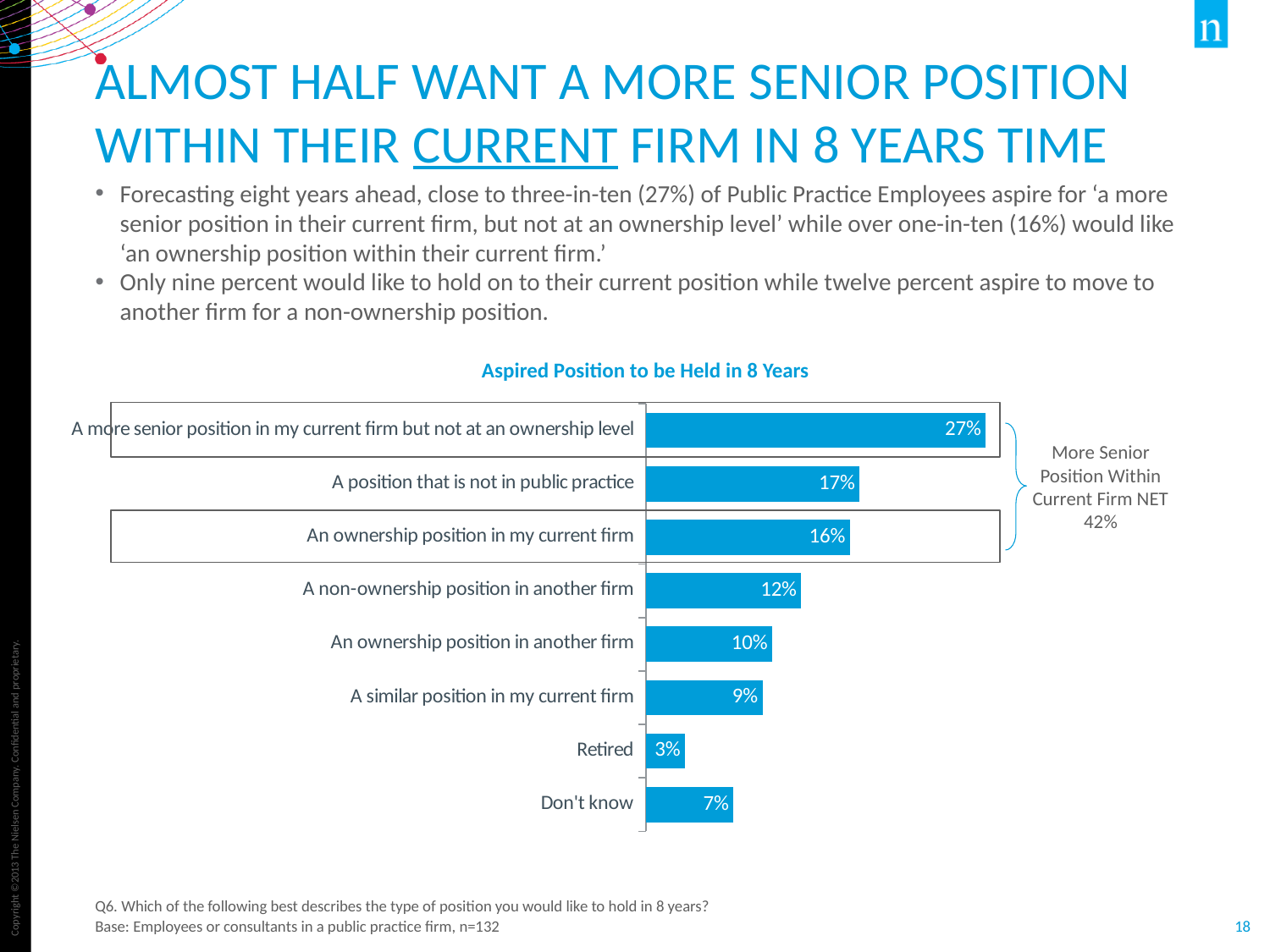
What is the title of the chart? Aspired Position to be Held in 8 Years Which category has the lowest value? Retired What is the difference between 'A more senior position in my current firm but not at an ownership level' and 'An ownership position in my current firm'? 11% What is the value for 'Retired'? 3% Which category has the highest value? A more senior position in my current firm but not at an ownership level What is the difference between 'Don't know' and 'Retired'? 4% How many categories are shown in the chart? 8 What is the value for 'An ownership position in another firm'? 10% What kind of chart is shown on the slide? Bar chart Which is larger: 'A non-ownership position in another firm' or 'A similar position in my current firm'? A non-ownership position in another firm What is the value for 'A position that is not in public practice'? 17% What is the 'More Senior Position Within Current Firm NET' value shown next to the chart? 42%